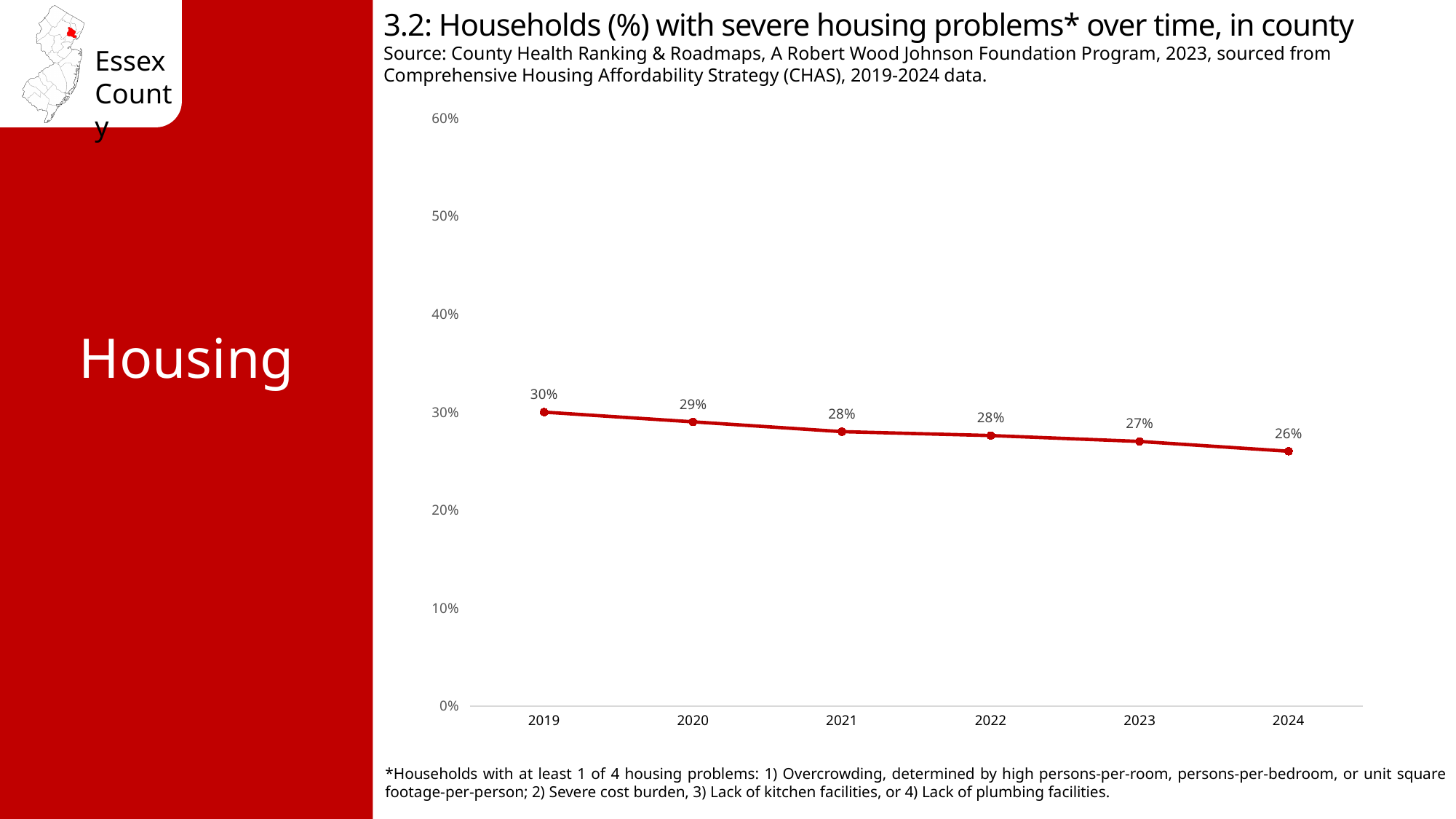
What kind of chart is shown on the slide? line chart How many years are plotted on the chart? 6 What is the difference in percentage points between 2019 and 2024? 4 What percentage of households had severe housing problems in 2019? 30% What is the value shown for 2023? 27% Is the value for 2021 greater or less than 40%? less Which year has a higher value, 2020 or 2023? 2020 What is the value shown for 2022? 28% Which year has the highest percentage of households with severe housing problems? 2019 Do the values rise or fall from 2019 to 2024? fall Which year has the lowest percentage of households with severe housing problems? 2024 What percentage of households had severe housing problems in 2024? 26%